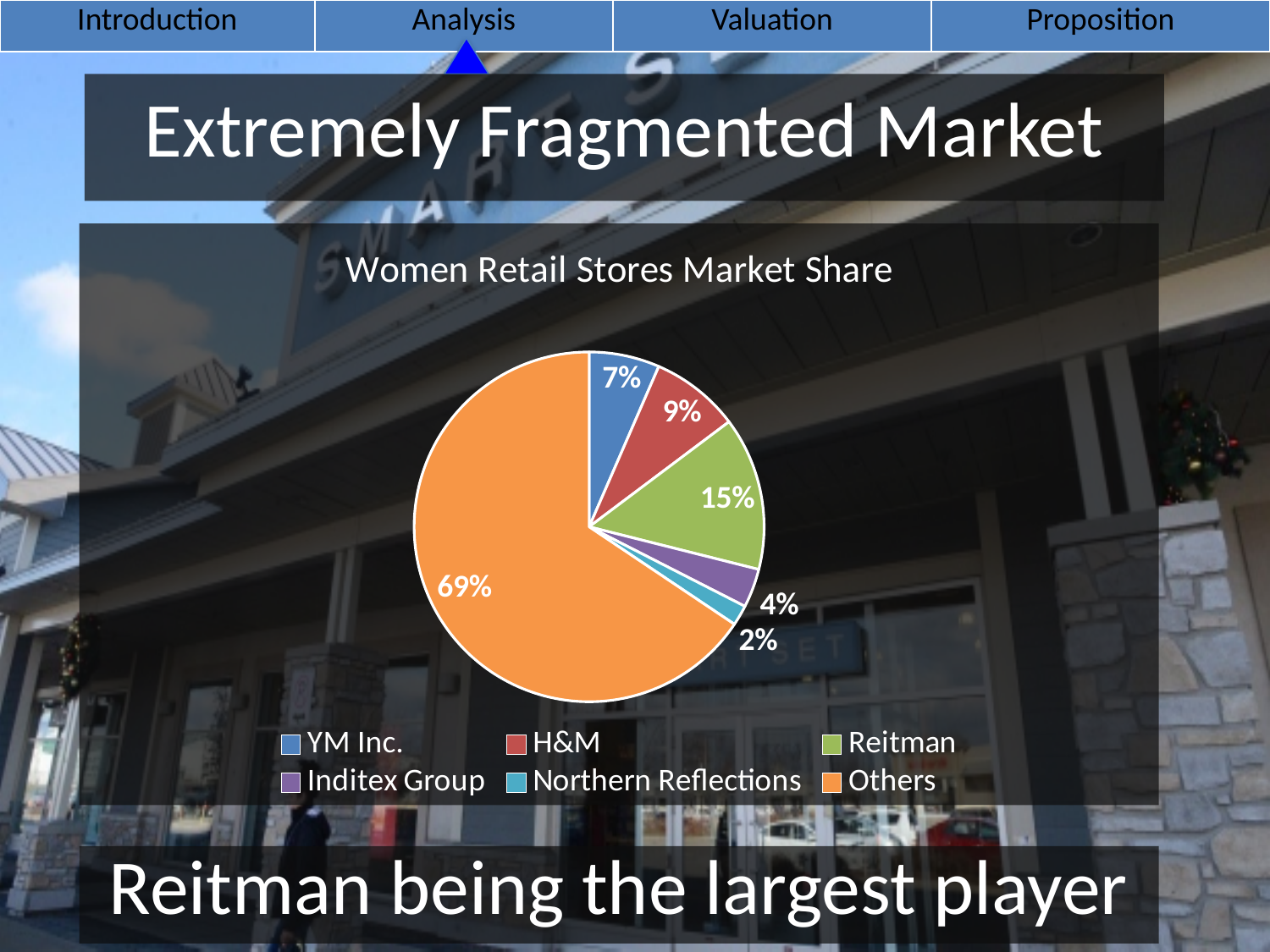
Which has a larger market share, Inditex Group or YM Inc.? YM Inc. Which named company (excluding Others) has the largest slice of the pie? Reitman What is the title of the chart? Women Retail Stores Market Share What share of the market is labelled Others? 69% What is the difference in market share between Reitman and H&M? 6% Which category has the smallest slice of the pie? Northern Reflections What share of the market does Reitman hold? 15% What type of chart is shown on the slide? pie chart How many categories does the legend list? 6 What share of the market does H&M hold? 9% What share of the market does YM Inc. hold? 7% What share of the market does Northern Reflections hold? 2%